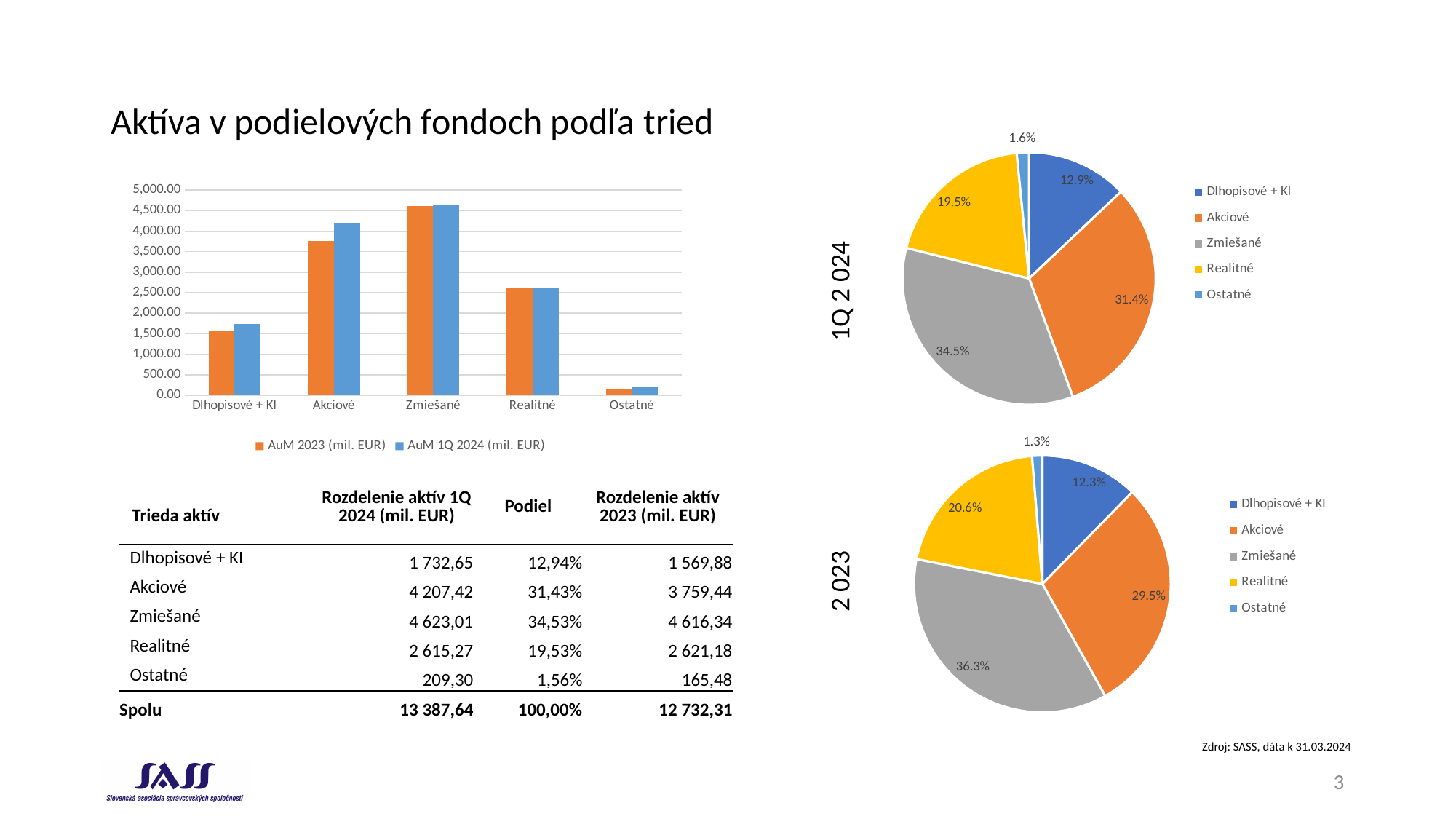
In the top-left bar chart, is the AuM 2023 (mil. EUR) value for Akciové greater or less than 4,000.00? less In the top-left bar chart, which category has the highest AuM 1Q 2024 (mil. EUR) value? Zmiešané What kind of chart is the chart at the top left of the slide? bar chart How many categories are shown on the x axis of the top-left bar chart? 5 How many series does the legend of the top-left bar chart list? 2 In the 2023 pie chart, which category has the smallest slice? Ostatné In the 1Q 2024 pie chart, what is the difference between the Zmiešané share and the Akciové share? 3.1 percentage points In the 2023 pie chart, what share does Realitné have? 20.6% In the 1Q 2024 pie chart, what share does Akciové have? 31.4% In the top-left bar chart, is the AuM 1Q 2024 (mil. EUR) value for Akciové greater or less than 4,000.00? greater In the top-left bar chart, for Akciové, which is larger: AuM 2023 (mil. EUR) or AuM 1Q 2024 (mil. EUR)? AuM 1Q 2024 (mil. EUR) In the top-left bar chart, which category has the lowest AuM 2023 (mil. EUR) value? Ostatné